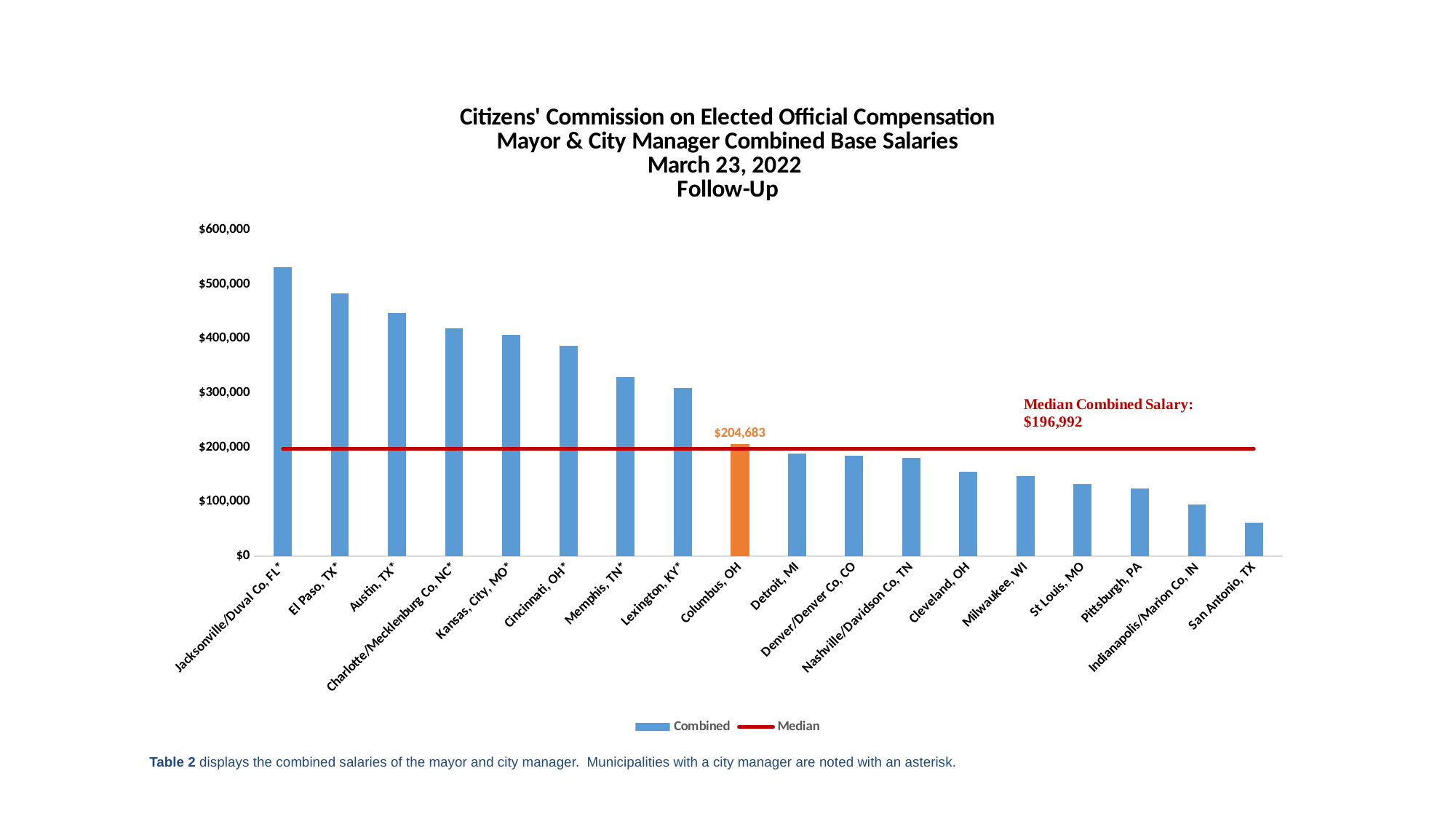
How many series does the legend list? 2 Do the bar values rise or fall moving from left to right along the x axis? Fall Which has a larger combined base salary, El Paso, TX* or Memphis, TN*? El Paso, TX* How much higher is the Columbus, OH combined salary than the median combined salary? $7,691 How many municipalities are shown on the x axis? 18 What is the median combined salary shown on the chart? $196,992 What kind of chart is shown on the slide? Bar chart Which municipality has the lowest combined base salary? San Antonio, TX What is the combined base salary value labelled for Columbus, OH? $204,683 Is the value for San Antonio, TX greater or less than $100,000? less Which municipality has the highest combined base salary? Jacksonville/Duval Co, FL* Is the value for Jacksonville/Duval Co, FL* greater or less than $500,000? greater